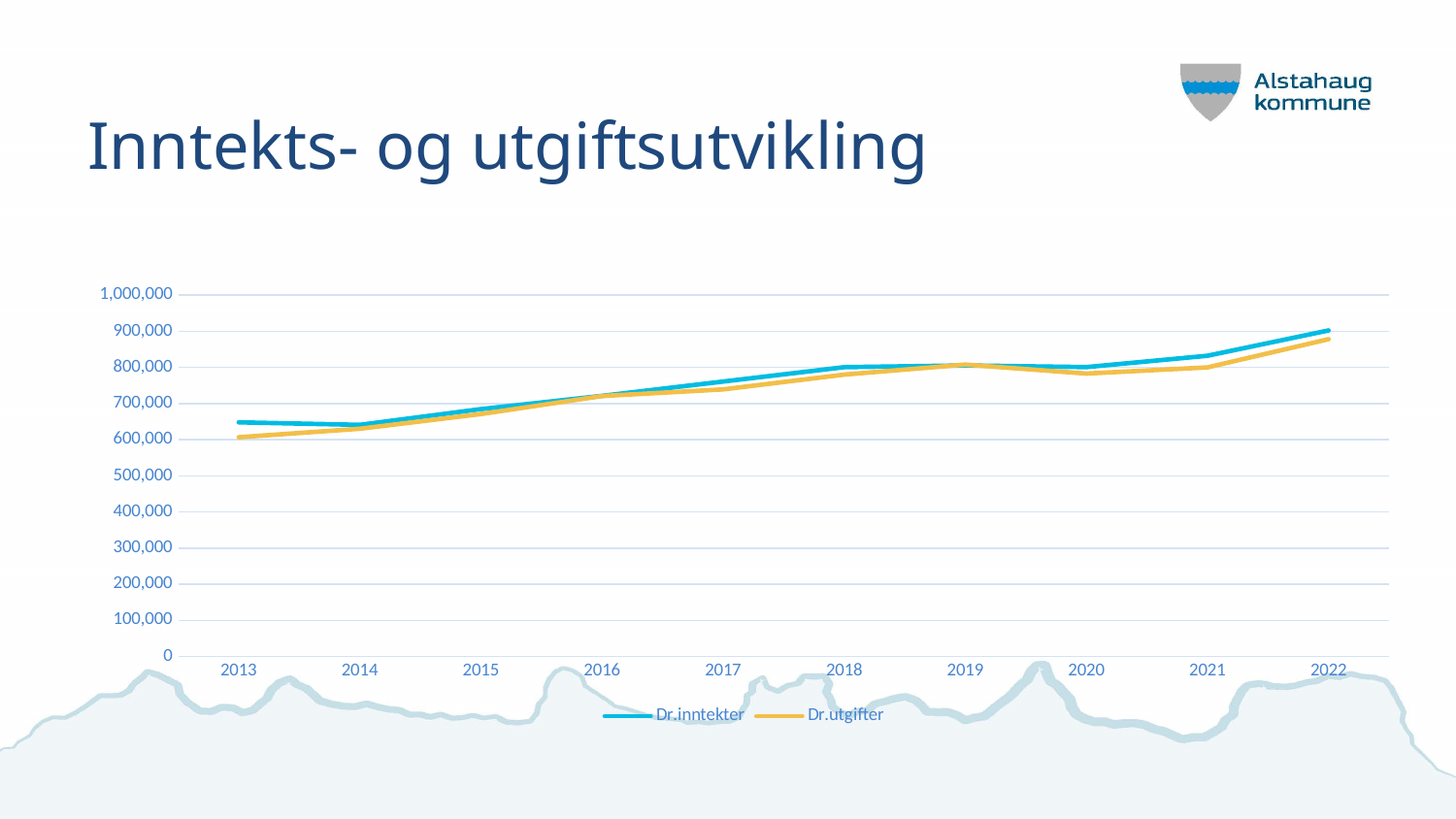
Is the value for Dr.utgifter in 2022 greater or less than 800,000? greater Do the values for Dr.utgifter generally rise or fall from 2013 to 2022? rise What kind of chart is shown on the slide? line chart How many series does the legend list? 2 Is the value for Dr.inntekter in 2013 greater or less than 600,000? greater How many years are shown on the x axis? 10 What is the title of the slide containing the chart? Inntekts- og utgiftsutvikling In which year is Dr.utgifter at its lowest? 2013 In 2013, which is larger: Dr.inntekter or Dr.utgifter? Dr.inntekter In which year is Dr.inntekter at its highest? 2022 Which series is drawn in yellow? Dr.utgifter Is the value for Dr.utgifter in 2013 greater or less than 700,000? less